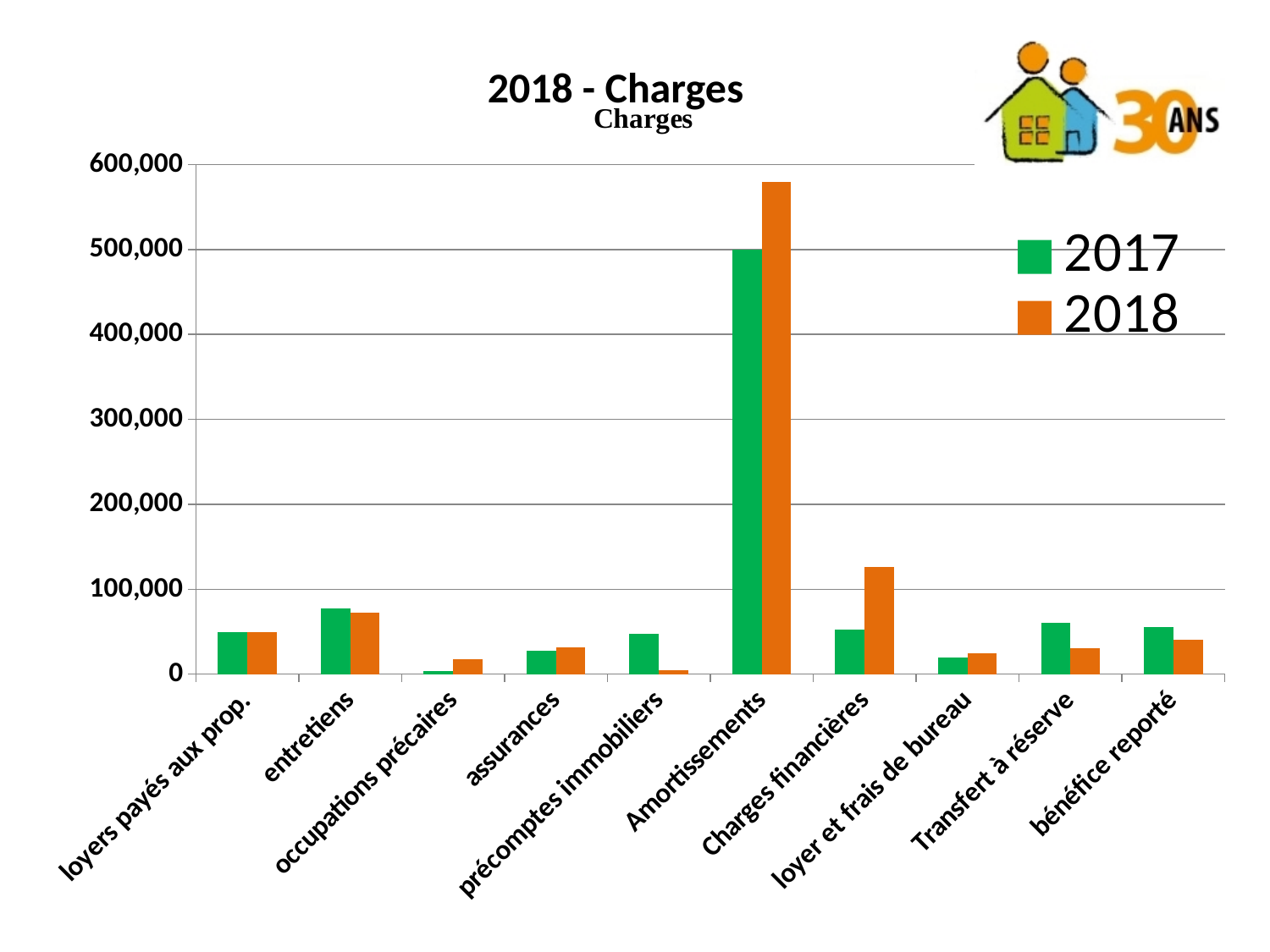
Which category has the highest value for 2018? Amortissements Is the 2017 value for entretiens greater or less than 100,000? less Which category has the highest value for 2017? Amortissements How many categories are shown on the x axis? 10 For Charges financières, which year has the larger value, 2017 or 2018? 2018 What kind of chart is shown on the slide? bar chart Which category has the lowest value for 2017? occupations précaires Which category has the lowest value for 2018? précomptes immobiliers Which colour represents the 2017 series in the legend? green Is the 2018 value for Amortissements greater or less than 500,000? greater How many series does the legend list? 2 Is the 2018 value for Charges financières greater or less than 100,000? greater